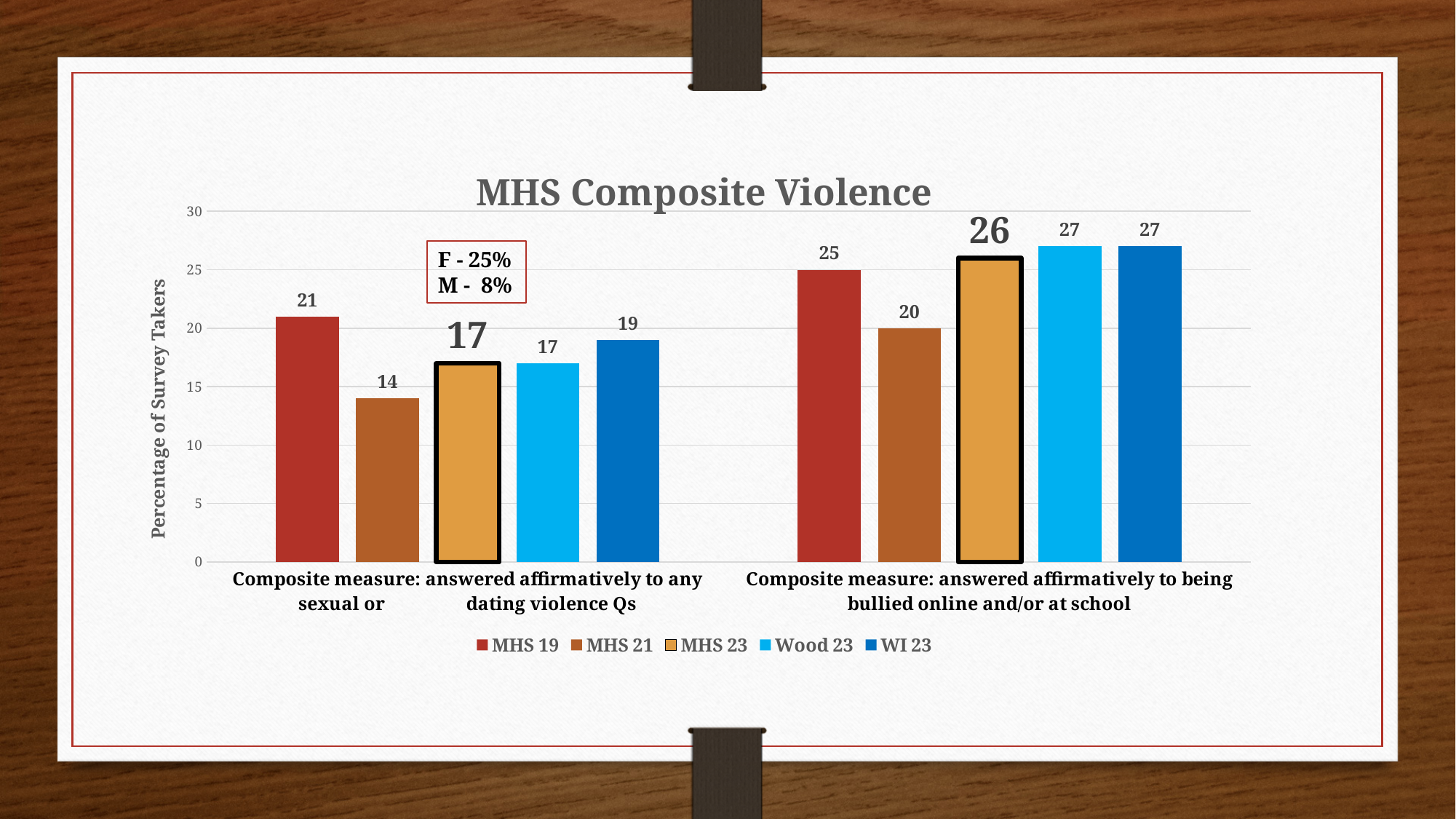
How many series does the legend list? 5 What kind of chart is shown on the slide? bar chart What is the value for MHS 21 in the dating violence category? 14 Which series has the highest value in the dating violence category? MHS 19 What is the value for MHS 23 in the 'Composite measure: answered affirmatively to being bullied online and/or at school' category? 26 Is the value for MHS 19 in the bullied online and/or at school category greater or less than 20? greater What is the label of the vertical axis? Percentage of Survey Takers What is the difference between the MHS 19 and MHS 21 values in the bullied online and/or at school category? 5 Which is larger in the bullied online and/or at school category: MHS 23 or Wood 23? Wood 23 What is the value for MHS 19 in the 'Composite measure: answered affirmatively to any sexual or dating violence Qs' category? 21 What is the title of the chart? MHS Composite Violence Which series has the lowest value in the dating violence category? MHS 21